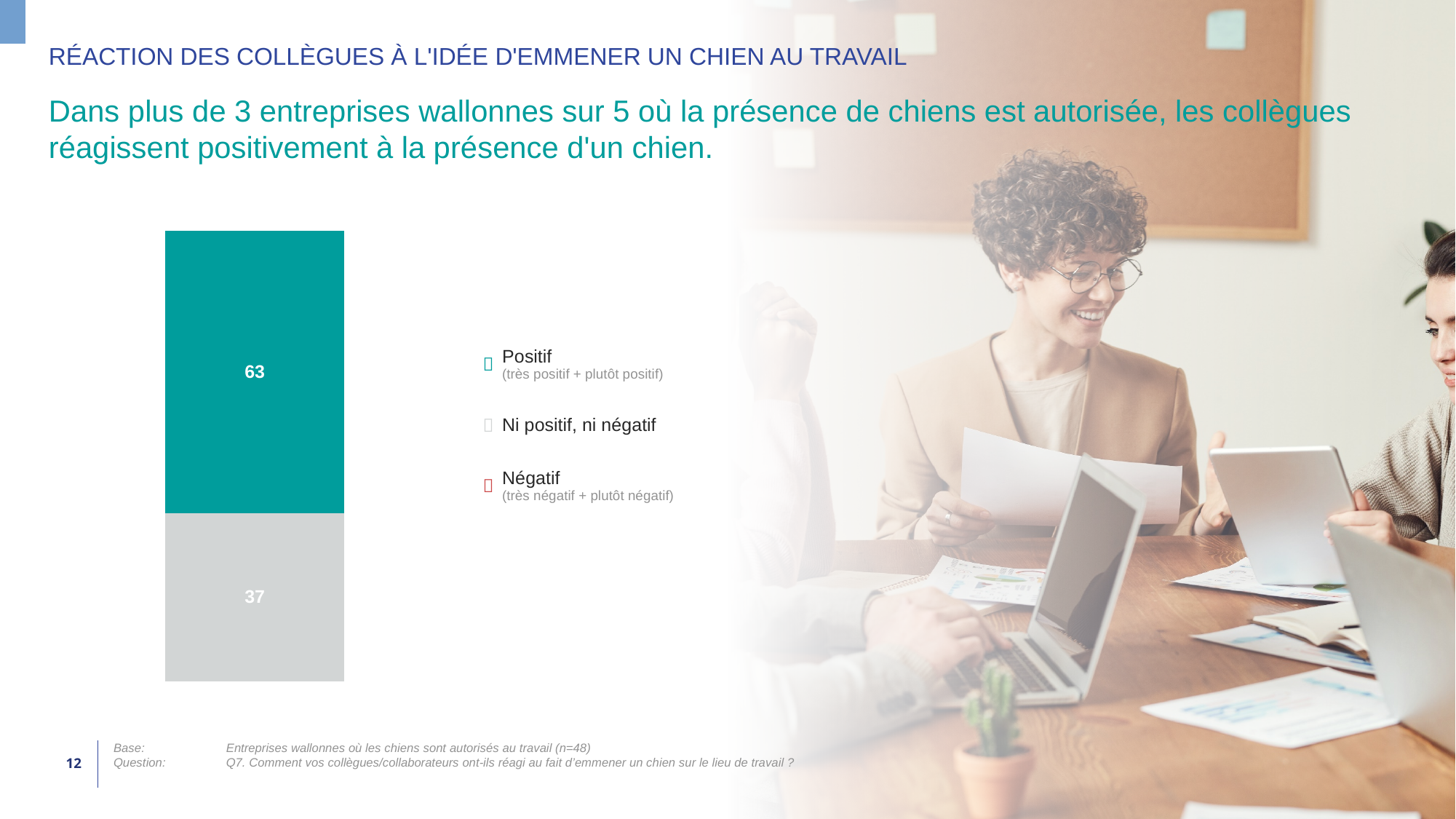
Which is larger: the Positif segment or the Ni positif, ni négatif segment? Positif What is the difference between the Positif value and the Ni positif, ni négatif value? 26 What value is shown for the Ni positif, ni négatif segment of the bar? 37 What colour is the Positif segment of the bar? Teal What kind of chart is shown on the slide? Stacked bar chart How many entries does the legend list? 3 How many segments with printed values does the stacked bar contain? 2 Which segment of the stacked bar has the largest value? Positif What value is shown for the Positif segment of the bar? 63 Of the two labelled segments in the bar, which has the smaller value? Ni positif, ni négatif What is the total of the two labelled segments in the stacked bar? 100 According to the legend, what does the Négatif category combine? très négatif + plutôt négatif